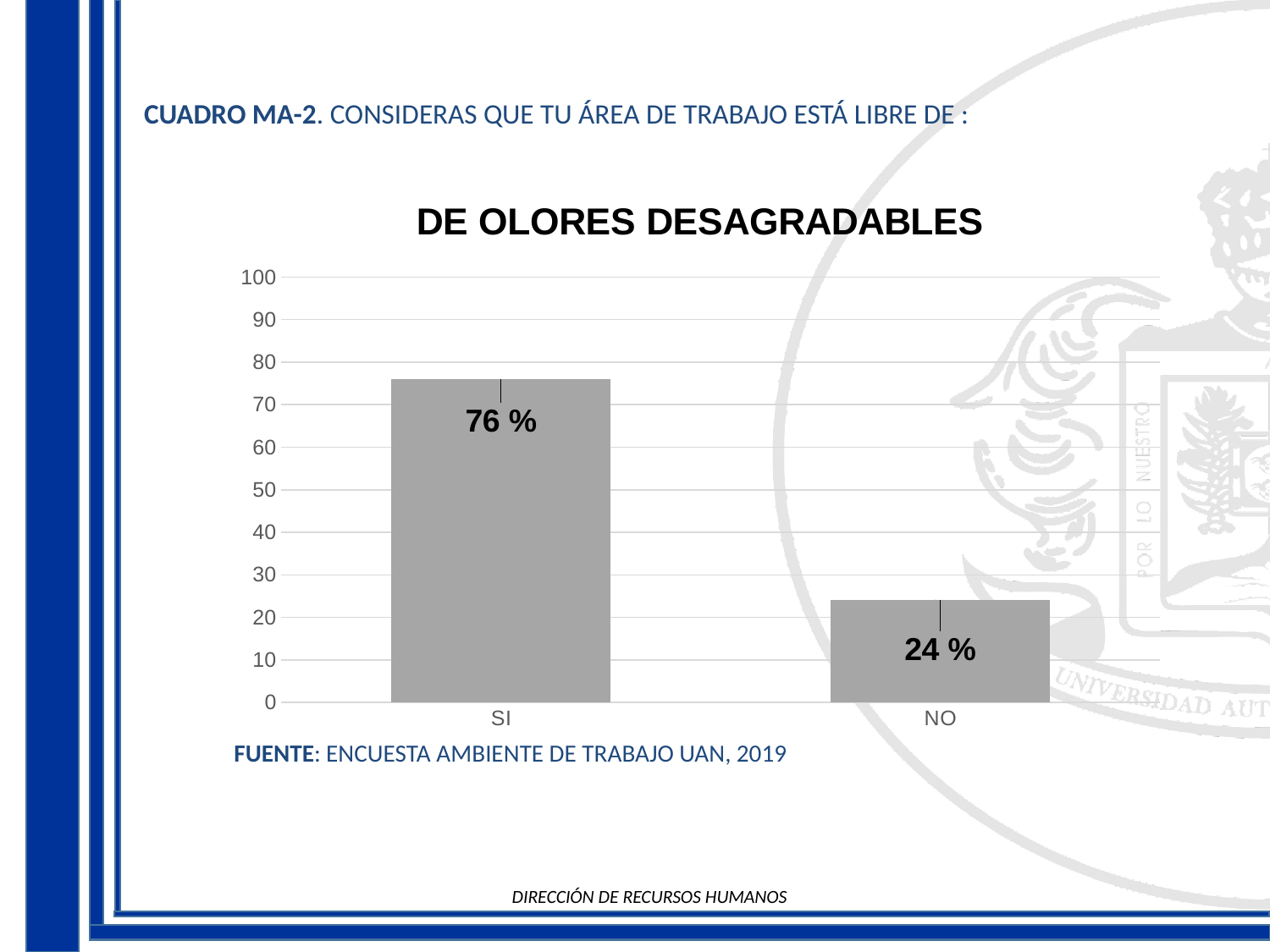
What is the highest value shown on the y axis? 100 What is the difference between the values for SI and NO? 52 % What is the value for NO? 24 % Is the value for NO greater or less than 30? less What is the title of the chart? DE OLORES DESAGRADABLES Which category has the highest value? SI Which is larger, the value for SI or the value for NO? SI Is the value for SI greater or less than 70? greater What kind of chart is shown? bar chart How many categories are shown on the x axis? 2 Which category has the lowest value? NO What is the value for SI? 76 %